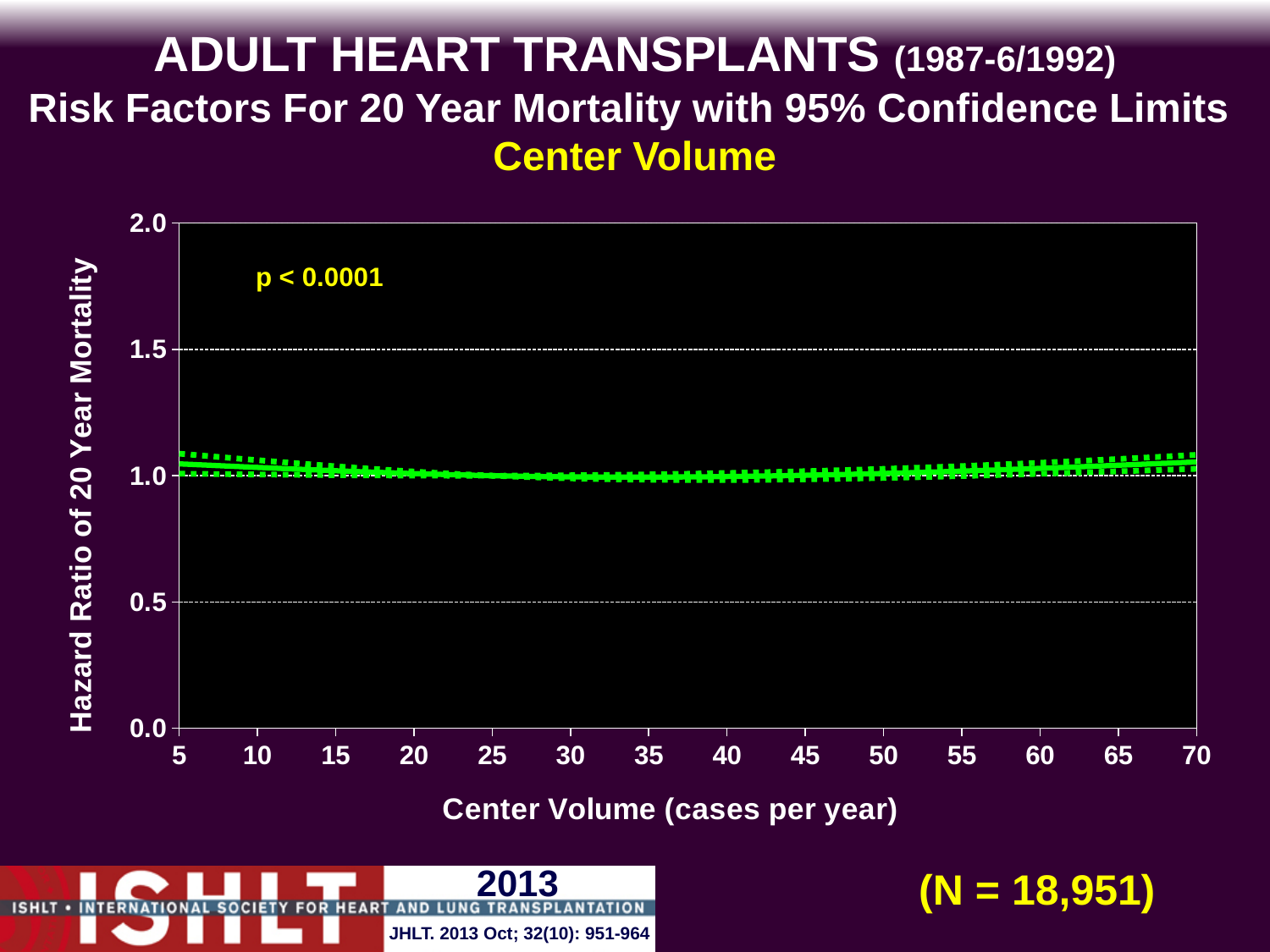
Is the hazard ratio at a center volume of 60 cases per year greater or less than 2.0? less How many tick labels are shown on the x axis (Center Volume)? 14 What kind of chart is shown on the slide? line chart Is the hazard ratio at a center volume of 20 cases per year greater or less than 0.5? greater Does the hazard ratio curve rise sharply, fall sharply, or stay roughly flat as center volume increases from 5 to 70? stay roughly flat Is the hazard ratio at a center volume of 40 cases per year greater or less than 1.5? less What p-value is printed on the chart? p < 0.0001 What is the highest value labelled on the y axis? 2.0 What sample size (N) is shown on the slide? N = 18,951